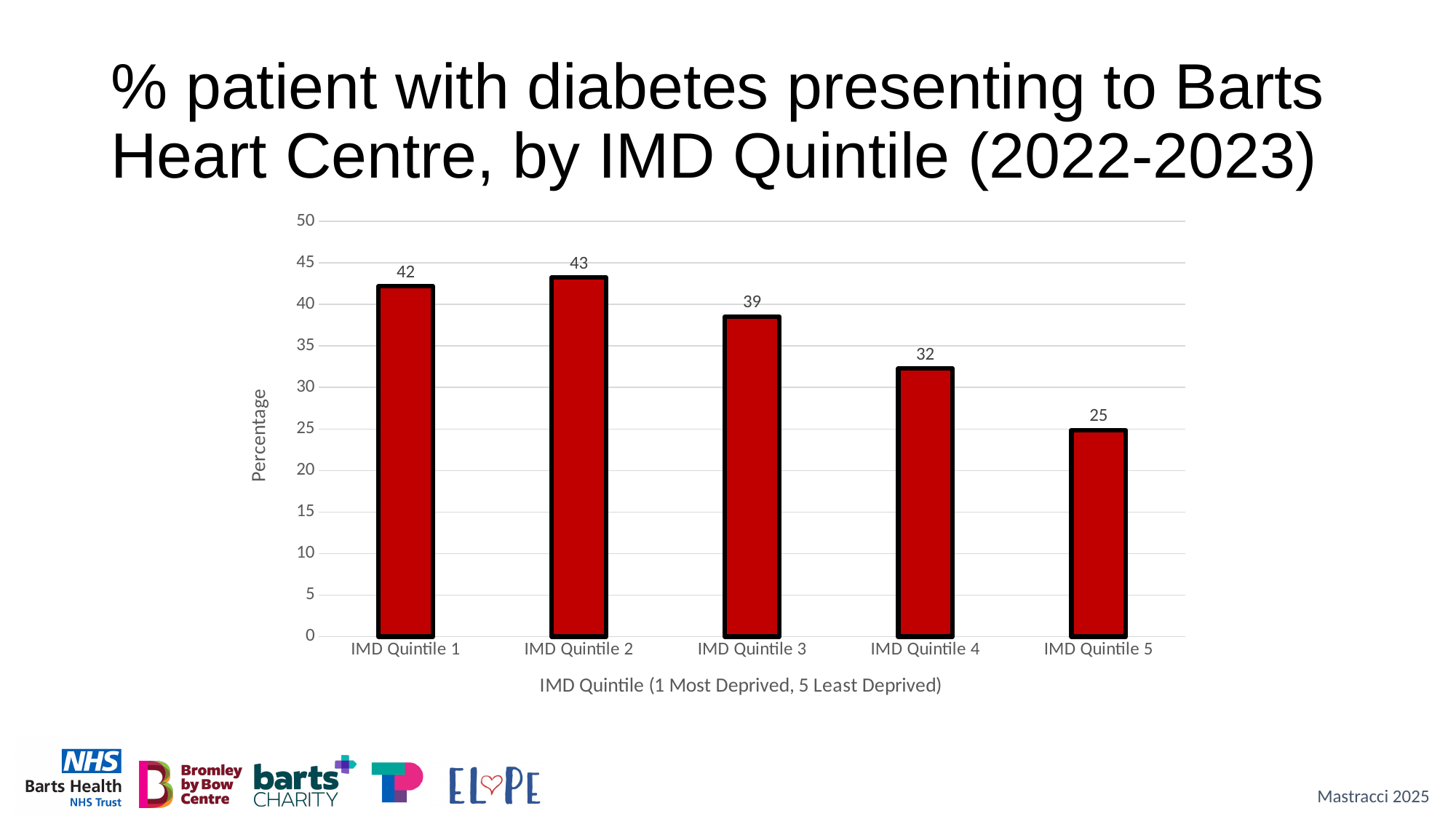
What kind of chart is shown on the slide? Bar chart What is the percentage for IMD Quintile 3? 39 Which has a larger percentage, IMD Quintile 1 or IMD Quintile 4? IMD Quintile 1 What is the percentage for IMD Quintile 5? 25 Which IMD quintile has the highest percentage? IMD Quintile 2 What is the percentage for IMD Quintile 1? 42 What is the label of the y axis? Percentage What is the difference between the percentages for IMD Quintile 3 and IMD Quintile 4? 7 How many IMD quintile categories are shown on the chart? 5 Is the value for IMD Quintile 4 greater or less than 30? greater Which IMD quintile has the lowest percentage? IMD Quintile 5 What is the difference between the percentages for IMD Quintile 2 and IMD Quintile 5? 18